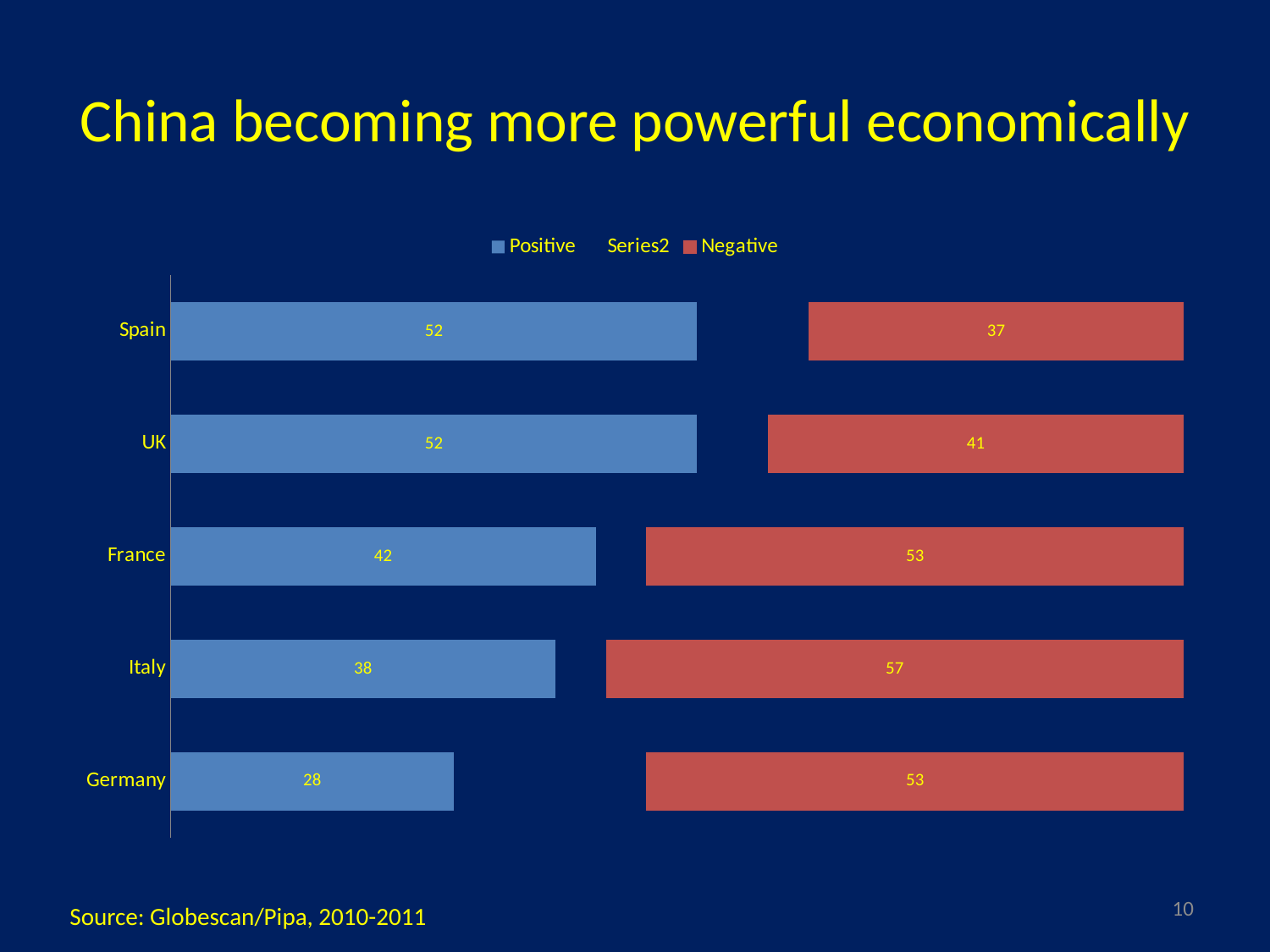
What kind of chart is shown on the slide? Bar chart How many countries are shown on the chart? 5 What is the Negative value for Italy? 57 What is the difference between the Negative and Positive values for Germany? 25 Which country has the lowest Positive value? Germany How many series does the legend list? 3 What is the Positive value for Spain? 52 What is the Negative value for UK? 41 What is the title of the slide? China becoming more powerful economically What is the Positive value for Germany? 28 Which is larger for France, the Positive value or the Negative value? Negative Which country has the highest Negative value? Italy